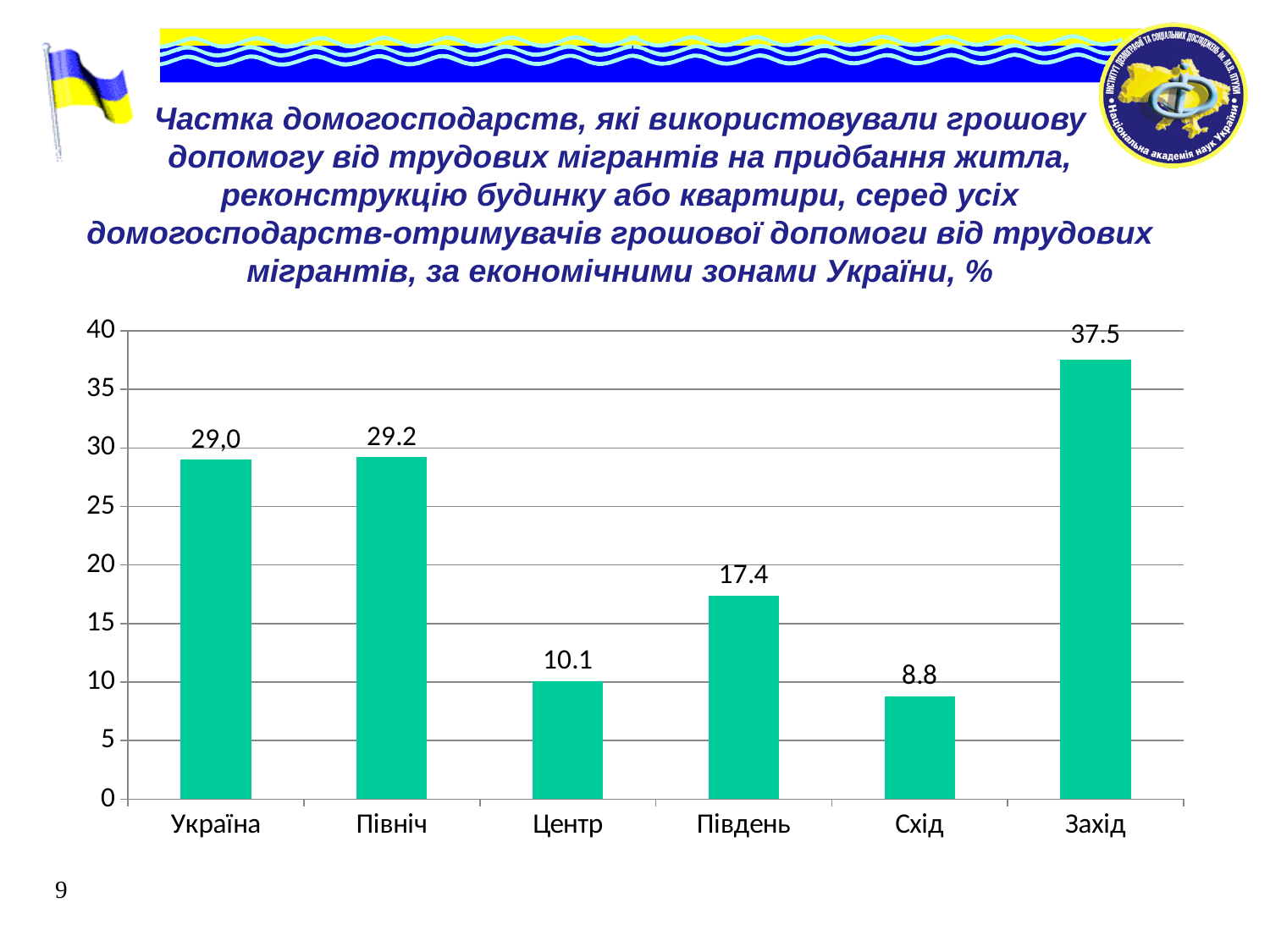
What is the value for Схід? 8.8 Which is larger, the value for Південь or the value for Центр? Південь What is the value for Україна? 29,0 What kind of chart is shown on the slide? bar chart What is the difference between the values for Захід and Схід? 28.7 What is the value for Захід? 37.5 Which category has the lowest value? Схід What is the difference between the values for Південь and Центр? 7.3 Which category has the highest value? Захід Is the value for Південь greater or less than 20? less How many categories are shown on the x axis? 6 What is the value for Центр? 10.1